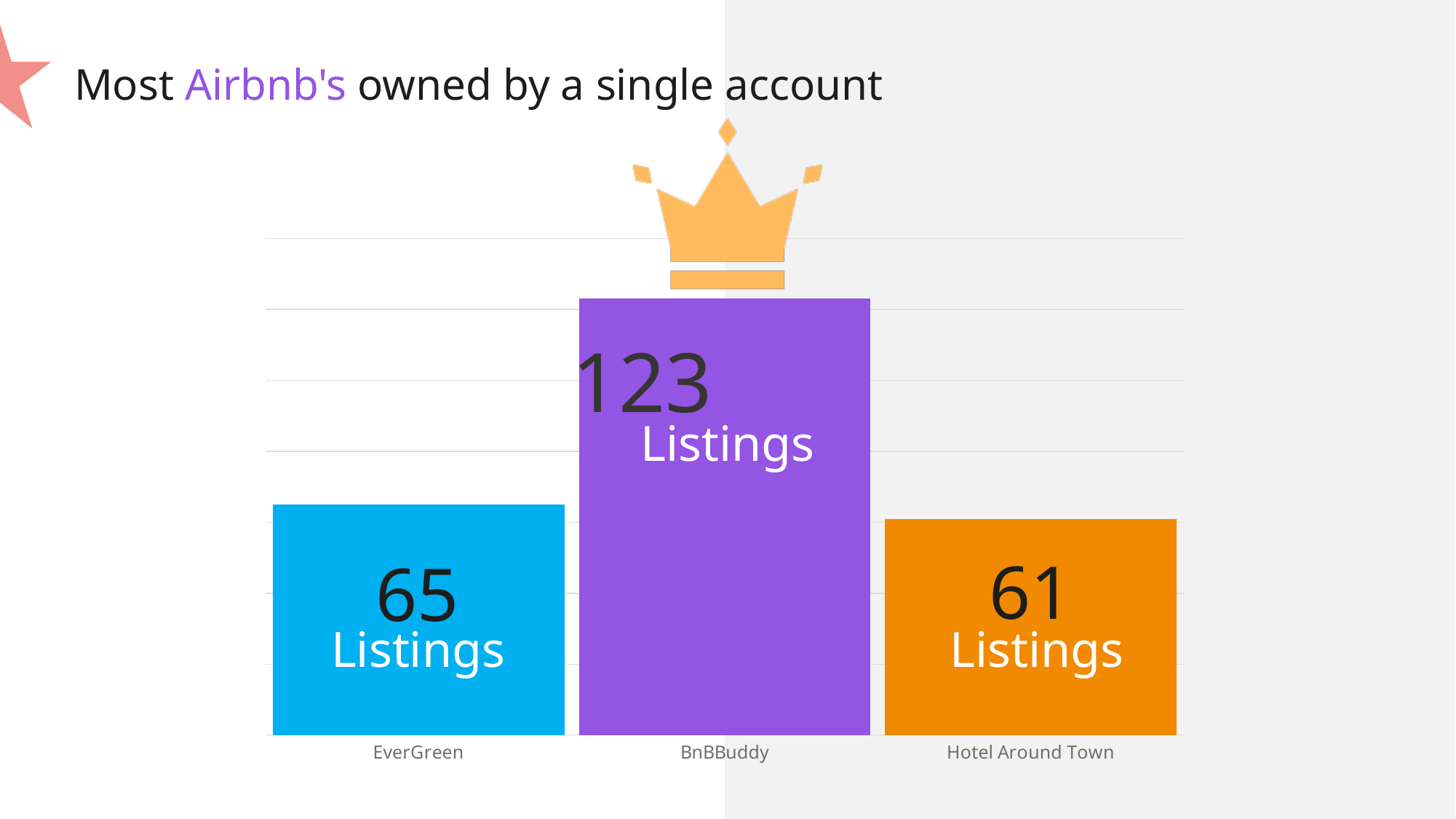
Which account has the most listings? BnBBuddy What is the difference in listings between BnBBuddy and EverGreen? 58 How many listings does Hotel Around Town have? 61 What is the title of the slide? Most Airbnb's owned by a single account How many accounts are shown in the chart? 3 Which account has the fewest listings? Hotel Around Town What colour is the bar for BnBBuddy? Purple How many listings does EverGreen have? 65 How many listings does BnBBuddy have? 123 What is the difference in listings between EverGreen and Hotel Around Town? 4 What kind of chart is shown on the slide? Bar chart Which has more listings, BnBBuddy or Hotel Around Town? BnBBuddy